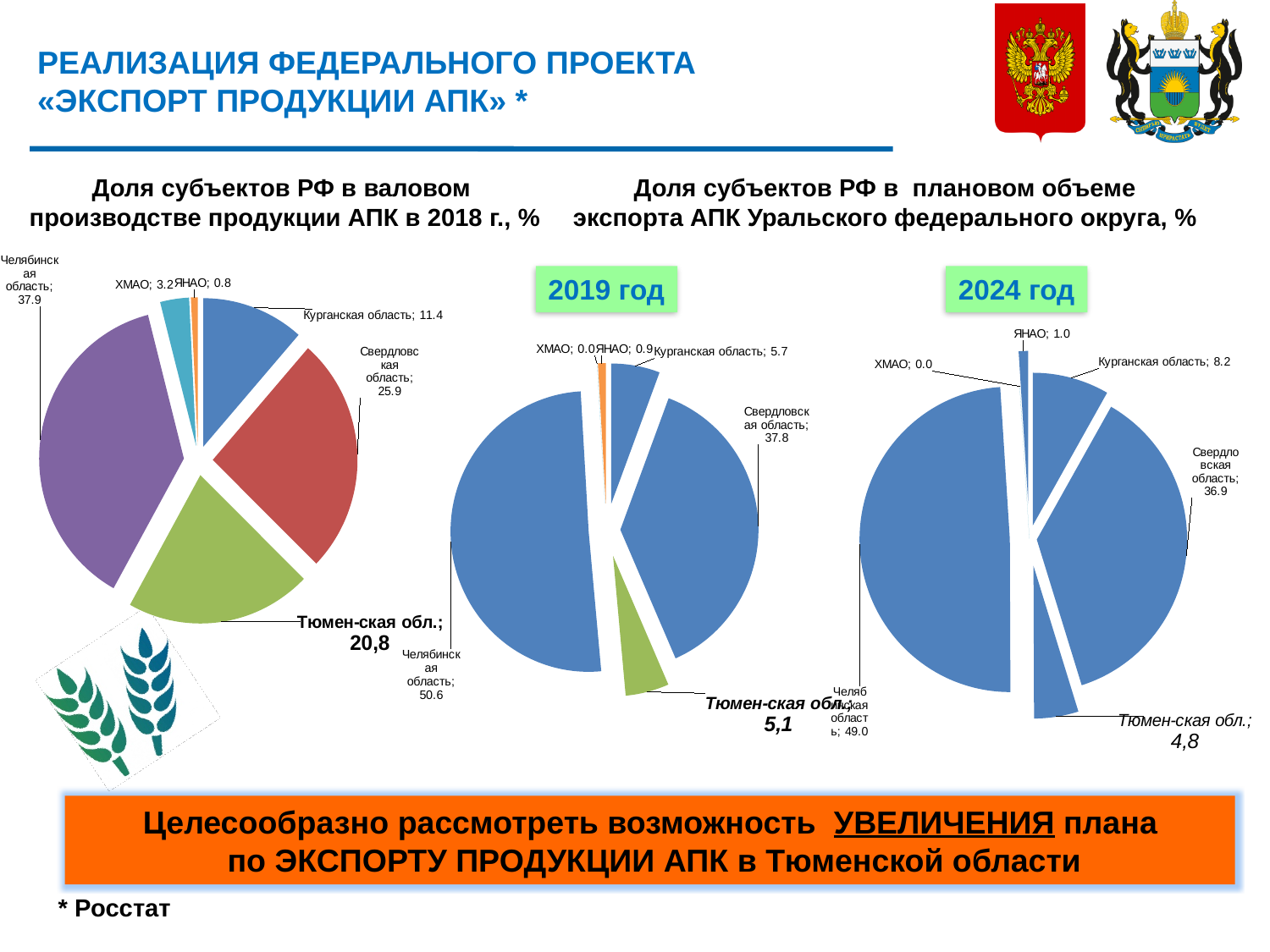
In the 2024 год pie chart, which is larger, the share of Свердловская область or Челябинская область? Челябинская область What type of chart is used for the 2024 год data? Pie chart In the 2018 gross agricultural production pie chart (left), which region has the smallest share? ЯНАО In the 2018 gross agricultural production pie chart (left), what share does Тюменская обл. have? 20,8 In the 2019 год pie chart, what share does Тюменская обл. have? 5,1 How many pie charts are shown on the slide? 3 In the 2018 gross agricultural production pie chart (left), what share does Челябинская область have? 37.9 In the 2019 год pie chart, which region has the largest share? Челябинская область In the 2019 год pie chart, what share does Свердловская область have? 37.8 In the 2018 gross agricultural production pie chart (left), which region has the largest share? Челябинская область In the 2024 год pie chart, what share does Курганская область have? 8.2 In the 2018 gross agricultural production pie chart (left), what is the difference between the shares of Свердловская область and Курганская область? 14.5